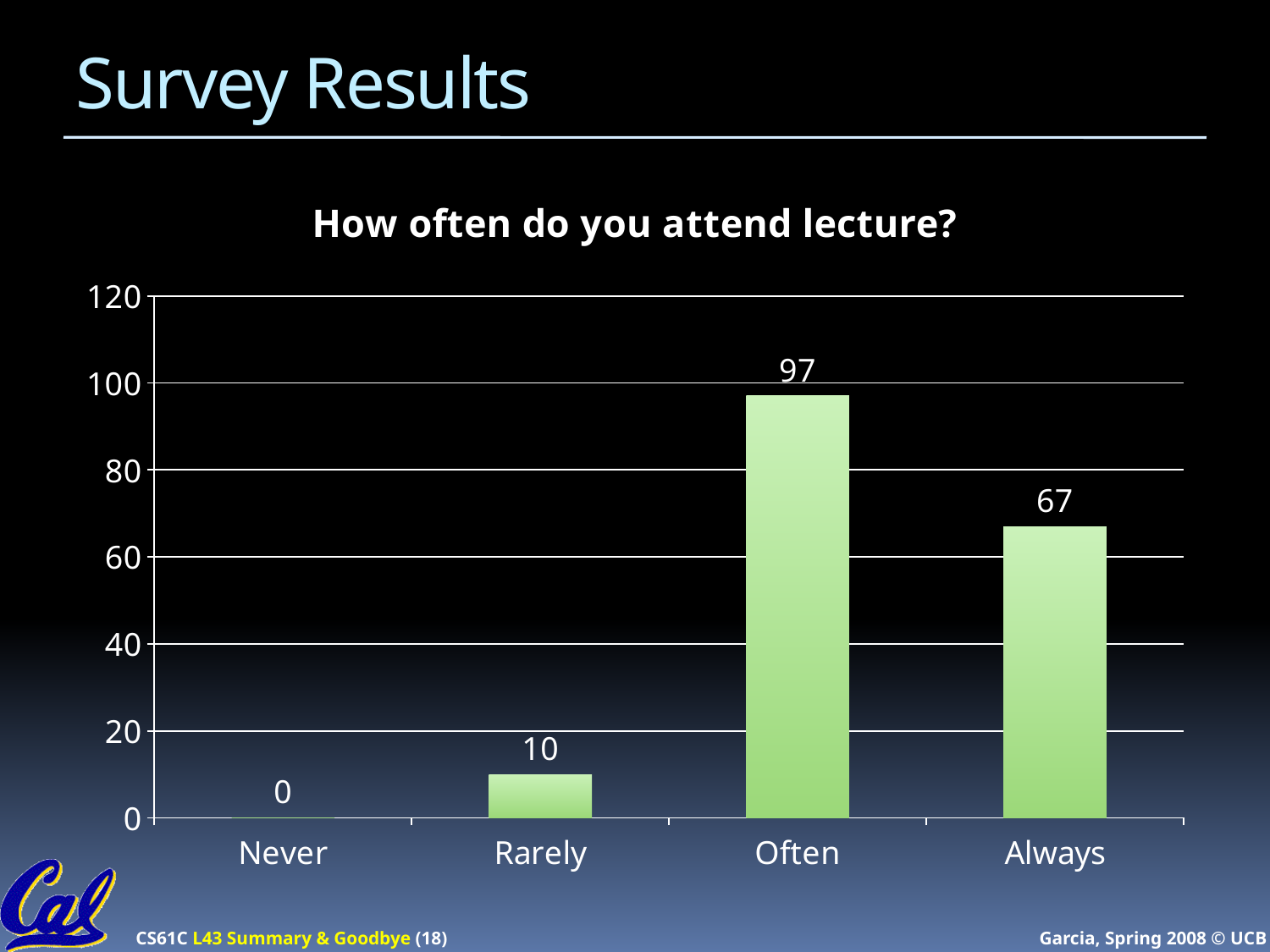
What is the difference between the values for Often and Always? 30 What is the value for Never? 0 Which is larger, the value for Rarely or the value for Always? Always What is the value for Always? 67 Which category has the lowest value? Never What kind of chart is shown? bar chart What is the value for Often? 97 Which category has the highest value? Often What is the title of the chart? How often do you attend lecture? Is the value for Often greater or less than 80? greater What is the value for Rarely? 10 How many categories are shown on the x axis? 4